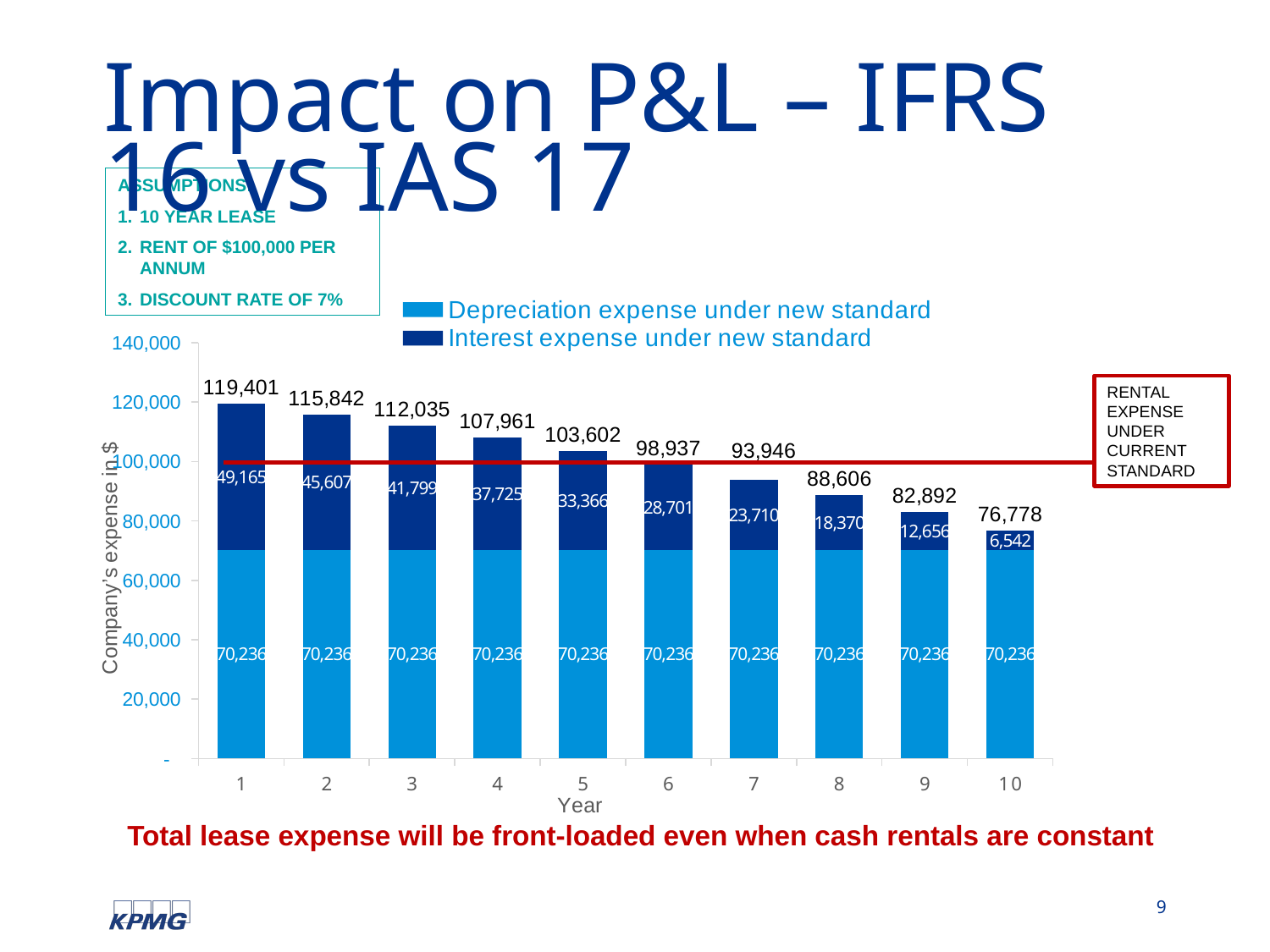
How many years are plotted on the x axis? 10 Which year has the highest total expense? 1 Which year has the lowest interest expense under the new standard? 10 What is the depreciation expense under the new standard in year 5? 70,236 What is the interest expense under the new standard in year 1? 49,165 What kind of chart is shown on the slide? Stacked bar chart What is the total expense shown above the bar for year 4? 107,961 Do the total expenses rise or fall from year 1 to year 10? Fall How many series does the legend list? 2 What is the interest expense under the new standard in year 10? 6,542 Is the interest expense in year 7 larger or smaller than in year 3? Smaller What is the difference between the total expense in year 1 and year 10? 42,623